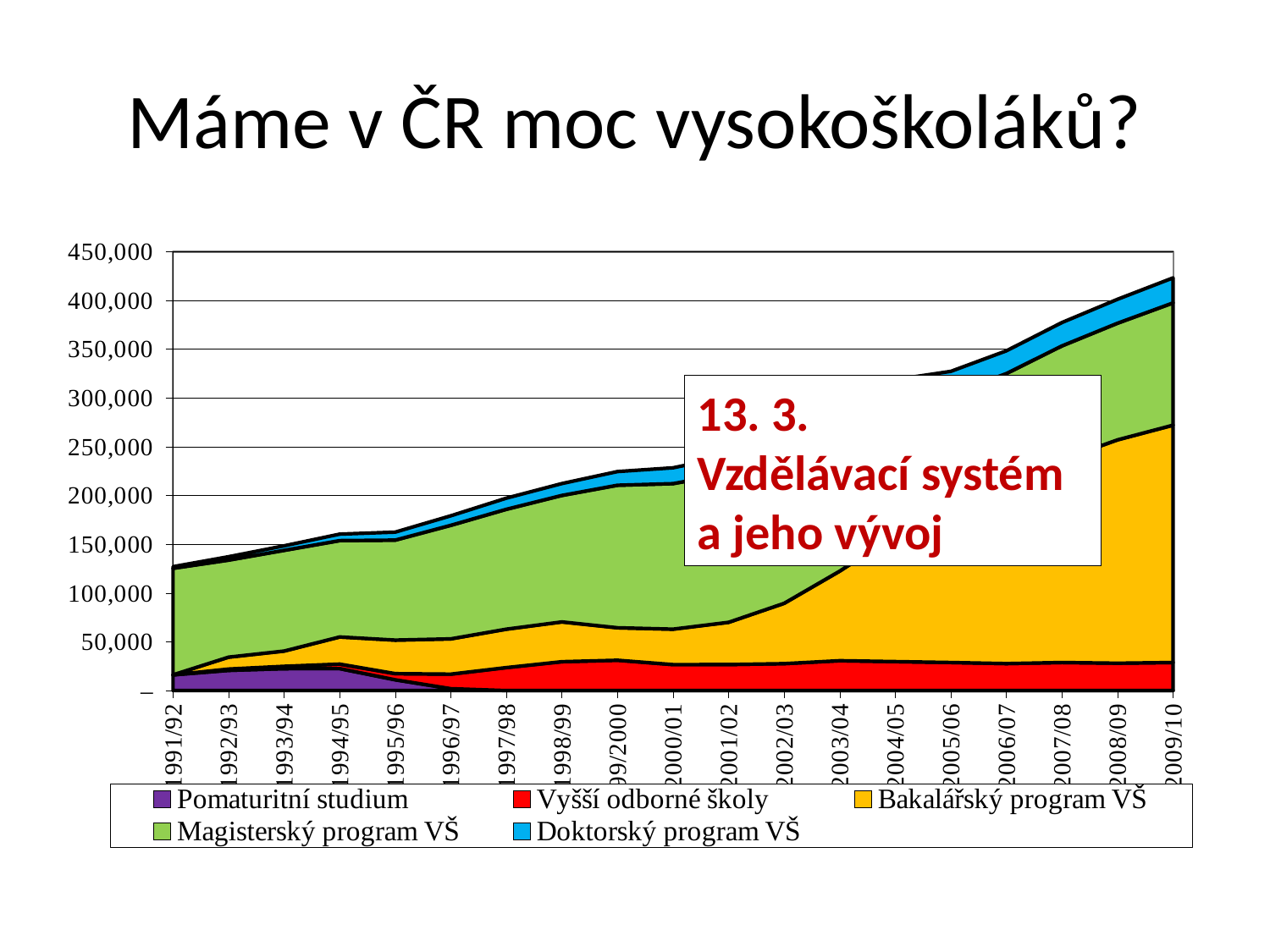
Is the total number of students in 2009/10 greater or less than 400,000? greater How many series does the legend list? 5 In which academic year is the total number of students lowest? 1991/92 Which series is plotted at the top of the stack? Doktorský program VŠ Which is larger, the total number of students in 2009/10 or in 1991/92? 2009/10 How many academic years are shown on the x axis? 19 Is the total number of students in 1991/92 greater or less than 150,000? less What kind of chart is shown on the slide? Stacked area chart In which academic year is the total number of students highest? 2009/10 Does the total number of students rise or fall from 1991/92 to 2009/10? Rises Is the total number of students in 2000/01 greater or less than 200,000? greater Which series is shown in yellow in the legend? Bakalářský program VŠ